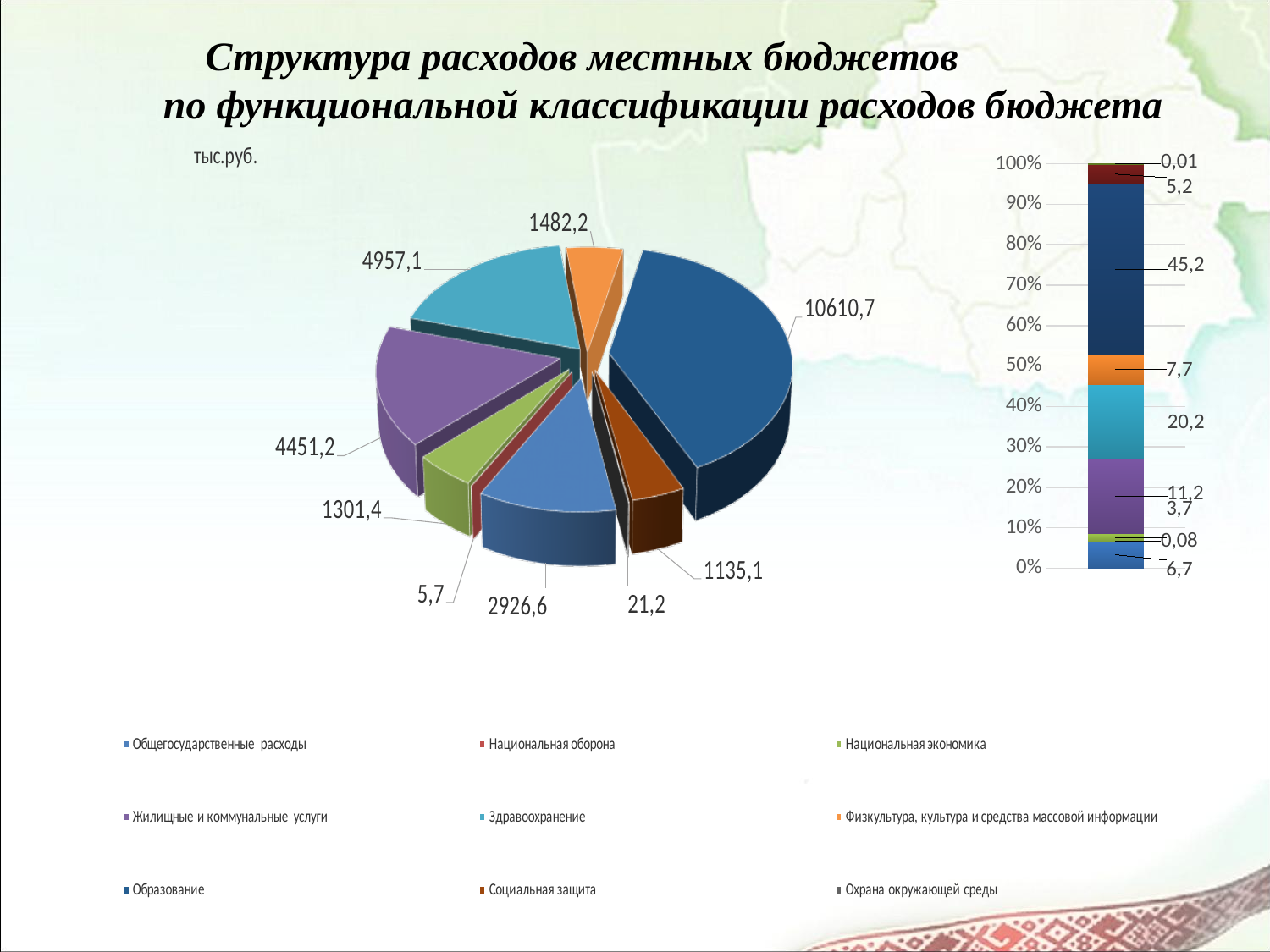
In the pie chart, what is the value for Образование? 10610,7 In the pie chart, what is the value for Социальная защита? 1135,1 In the pie chart, which category has the largest value? Образование How many categories does the legend list? 9 In the stacked bar chart on the right, what percentage is shown for the Образование segment? 45,2 In the pie chart, which is larger: Общегосударственные расходы or Физкультура, культура и средства массовой информации? Общегосударственные расходы In the stacked bar chart on the right, what percentage is shown for the Здравоохранение segment? 20,2 What type of chart is shown on the left of the slide? pie chart In the pie chart, what is the value for Жилищные и коммунальные услуги? 4451,2 In the pie chart, which category has the smallest value? Национальная оборона In the pie chart, what is the difference between the values for Здравоохранение and Жилищные и коммунальные услуги? 505,9 In the pie chart, what is the value for Здравоохранение? 4957,1